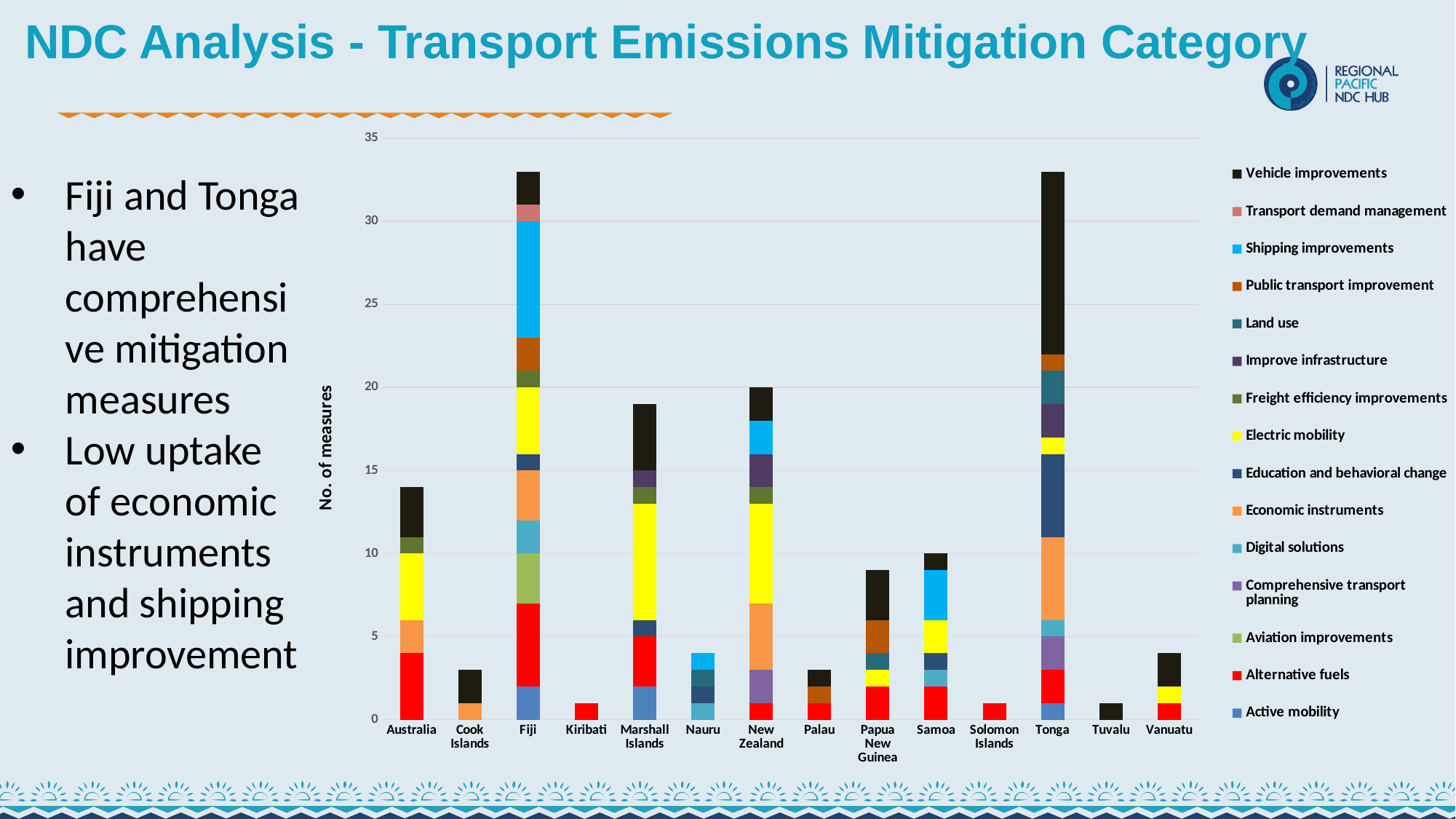
Is the total number of measures for Australia greater or less than 10? greater Which has more measures in total, Australia or Samoa? Australia Is the total number of measures for Papua New Guinea greater or less than 10? less What is the label of the vertical axis? No. of measures How many countries are shown along the x axis of the chart? 14 Which legend entry is shown in yellow? Electric mobility How many series does the chart's legend list? 15 Is the total number of measures for Tonga greater or less than 25? greater Which has more measures in total, Fiji or Marshall Islands? Fiji What kind of chart is shown on the slide? Stacked bar chart